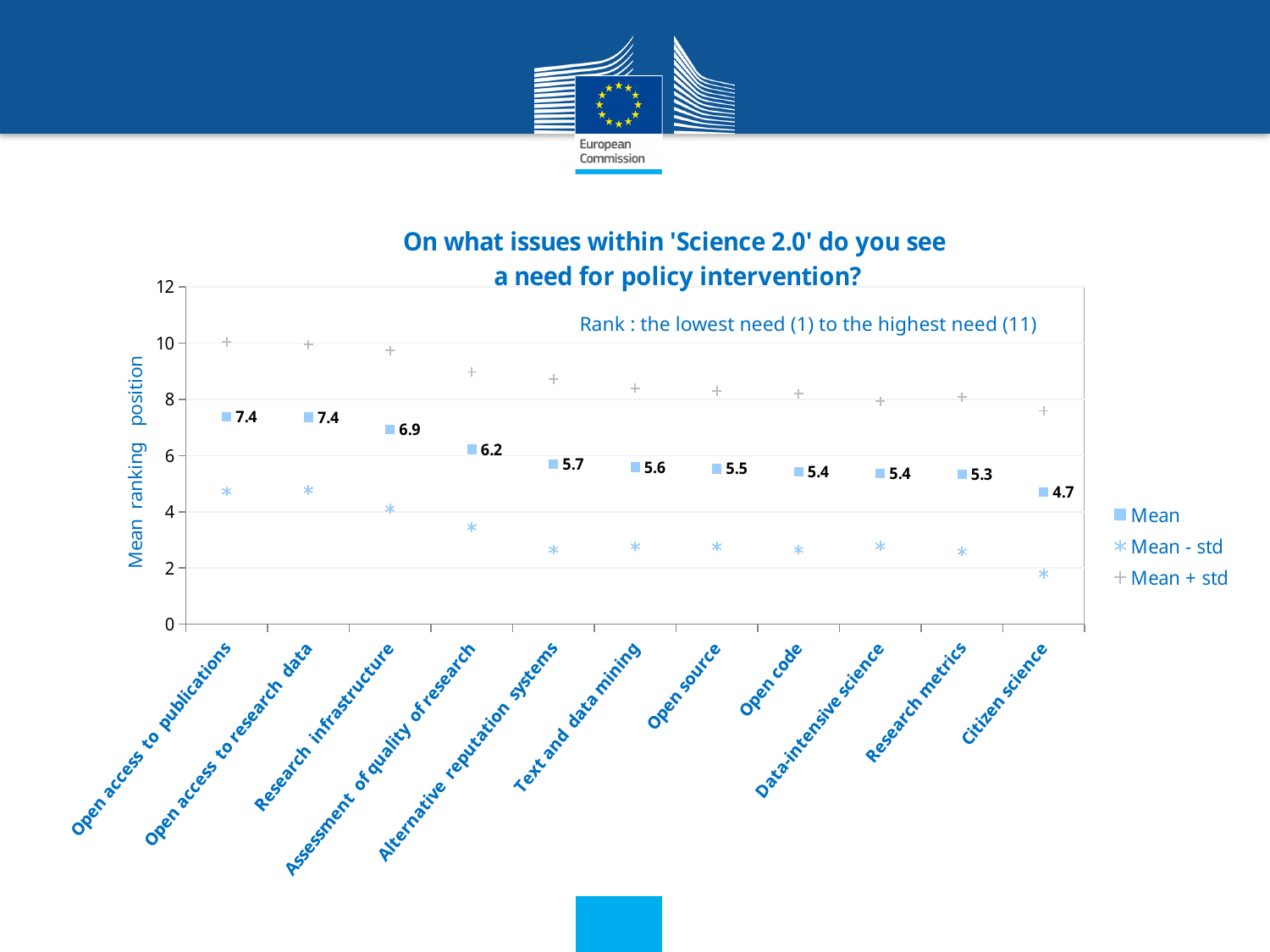
How many series does the legend list? 3 What is the Mean value for Assessment of quality of research? 6.2 What is the Mean value for Research infrastructure? 6.9 What is the difference between the Mean value for Open access to publications and the Mean value for Citizen science? 2.7 Do the Mean values rise or fall from left to right along the x axis? fall Is the Mean + std value for Assessment of quality of research greater or less than 8? greater Which category has the lowest Mean value? Citizen science Is the Mean - std value for Open access to publications greater or less than 6? less How many categories are shown on the x axis? 11 What is the Mean value for Text and data mining? 5.6 Which has a higher Mean value, Research infrastructure or Open source? Research infrastructure What is the Mean value for Citizen science? 4.7